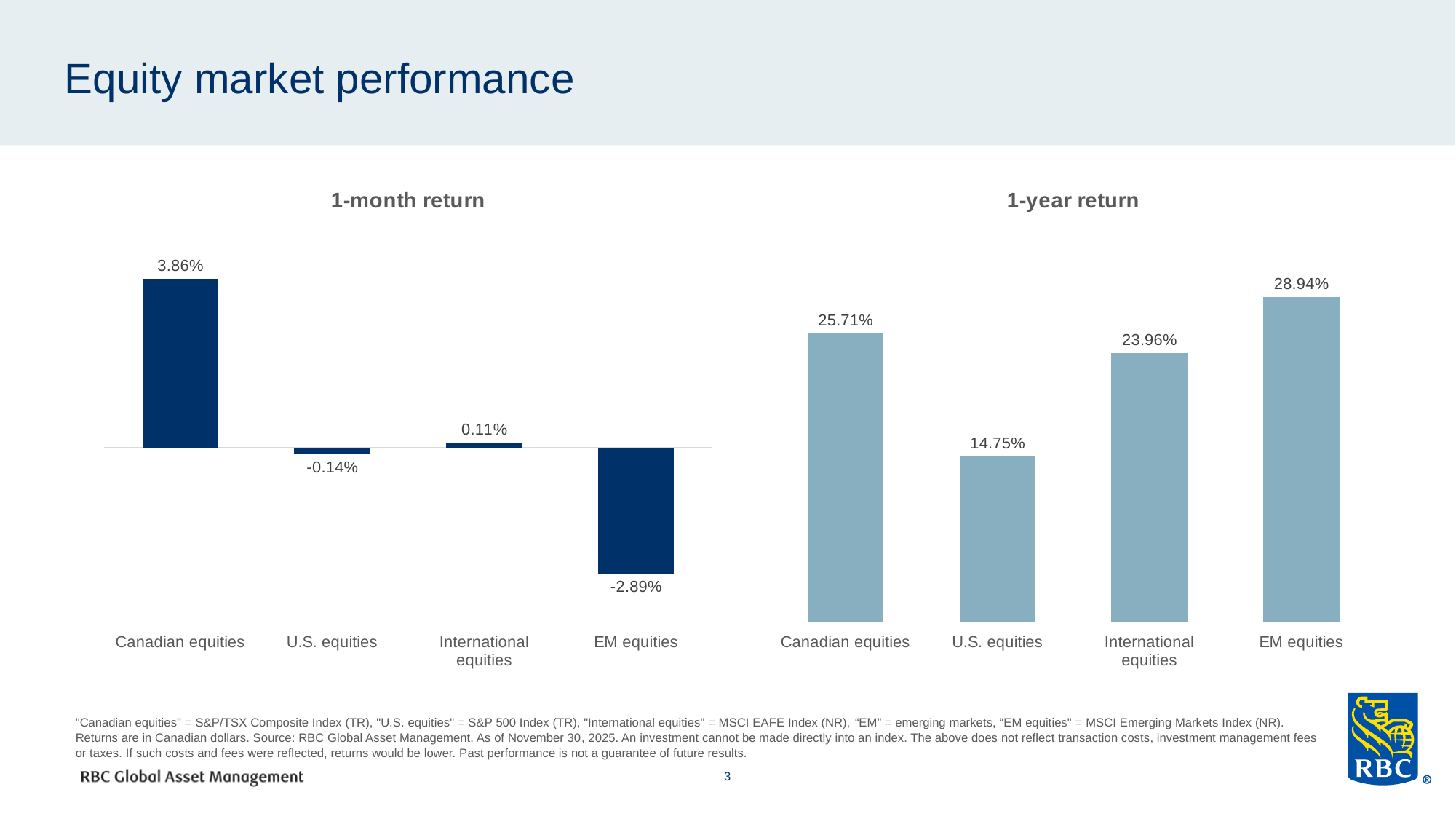
In the 1-month return chart, which category has the lowest value? EM equities In the 1-month return chart, what is the value for Canadian equities? 3.86% In the 1-year return chart, which category has the lowest value? U.S. equities What is the title of the chart on the left side of the slide? 1-month return In the 1-year return chart, what is the difference between EM equities and Canadian equities? 3.23% What kind of chart is the 1-year return chart? Bar chart In the 1-year return chart, what is the value for U.S. equities? 14.75% In the 1-year return chart, which category has the highest value? EM equities In the 1-month return chart, what is the value for EM equities? -2.89% In the 1-year return chart, what is the value for International equities? 23.96% How many categories are shown in the 1-month return chart? 4 In the 1-month return chart, which is larger: the value for U.S. equities or the value for International equities? International equities